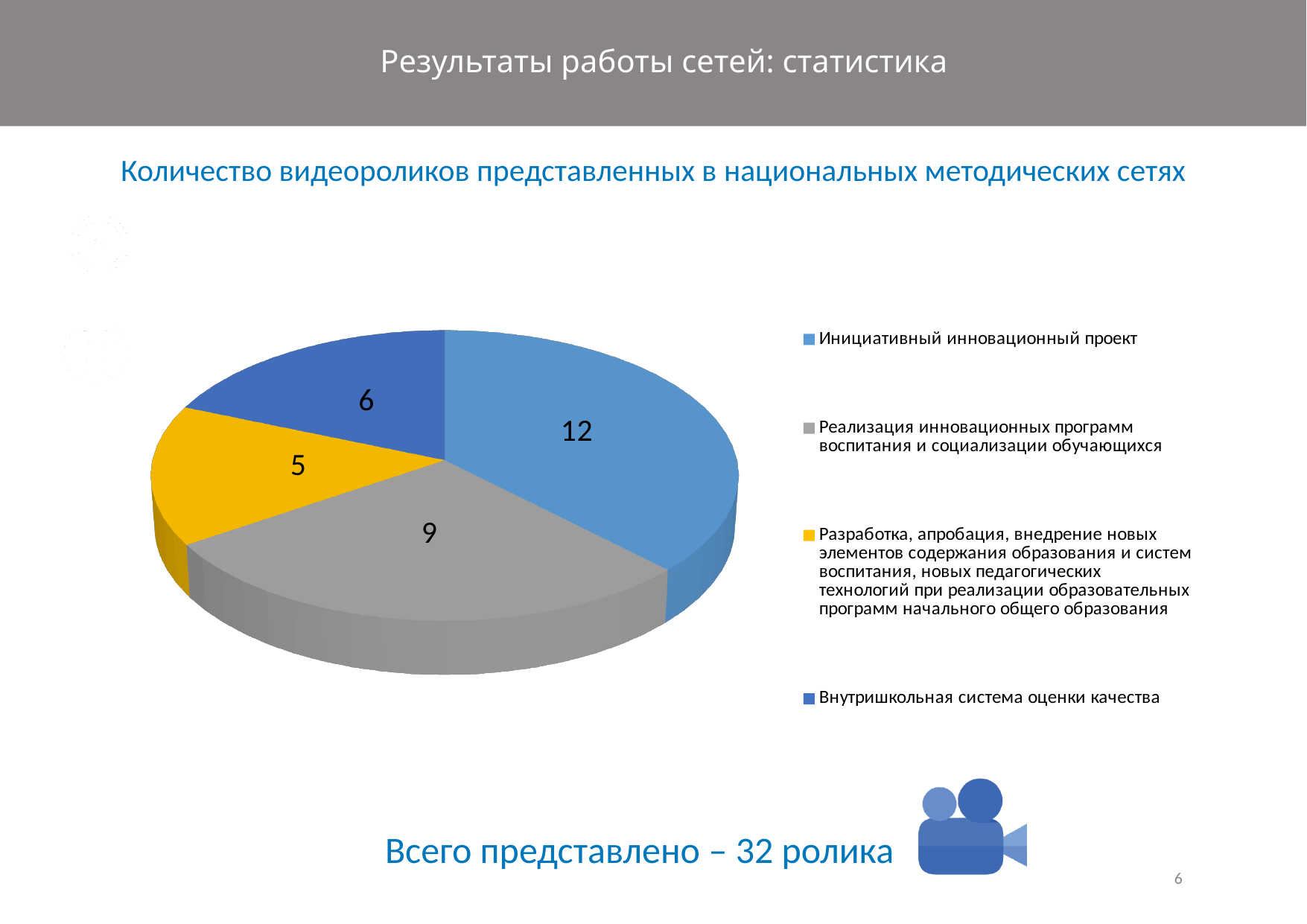
What is the total of all slices in the pie chart? 32 Which category has the largest slice of the pie? Инициативный инновационный проект How many slices does the pie chart have? 4 What is the value of the yellow slice ("Разработка, апробация, внедрение новых элементов содержания образования...")? 5 What is the difference between the values for "Инициативный инновационный проект" and "Внутришкольная система оценки качества"? 6 Which is larger: the slice for "Реализация инновационных программ воспитания и социализации обучающихся" or the slice for "Внутришкольная система оценки качества"? Реализация инновационных программ воспитания и социализации обучающихся What is the value of the slice for "Реализация инновационных программ воспитания и социализации обучающихся"? 9 What kind of chart is shown on the slide? Pie chart How many videos are shown for "Инициативный инновационный проект"? 12 What is the value of the slice for "Внутришкольная система оценки качества"? 6 Which category has the smallest slice of the pie? Разработка, апробация, внедрение новых элементов содержания образования и систем воспитания, новых педагогических технологий при реализации образовательных программ начального общего образования What share of the pie does the slice for "Инициативный инновационный проект" represent? 37.5%